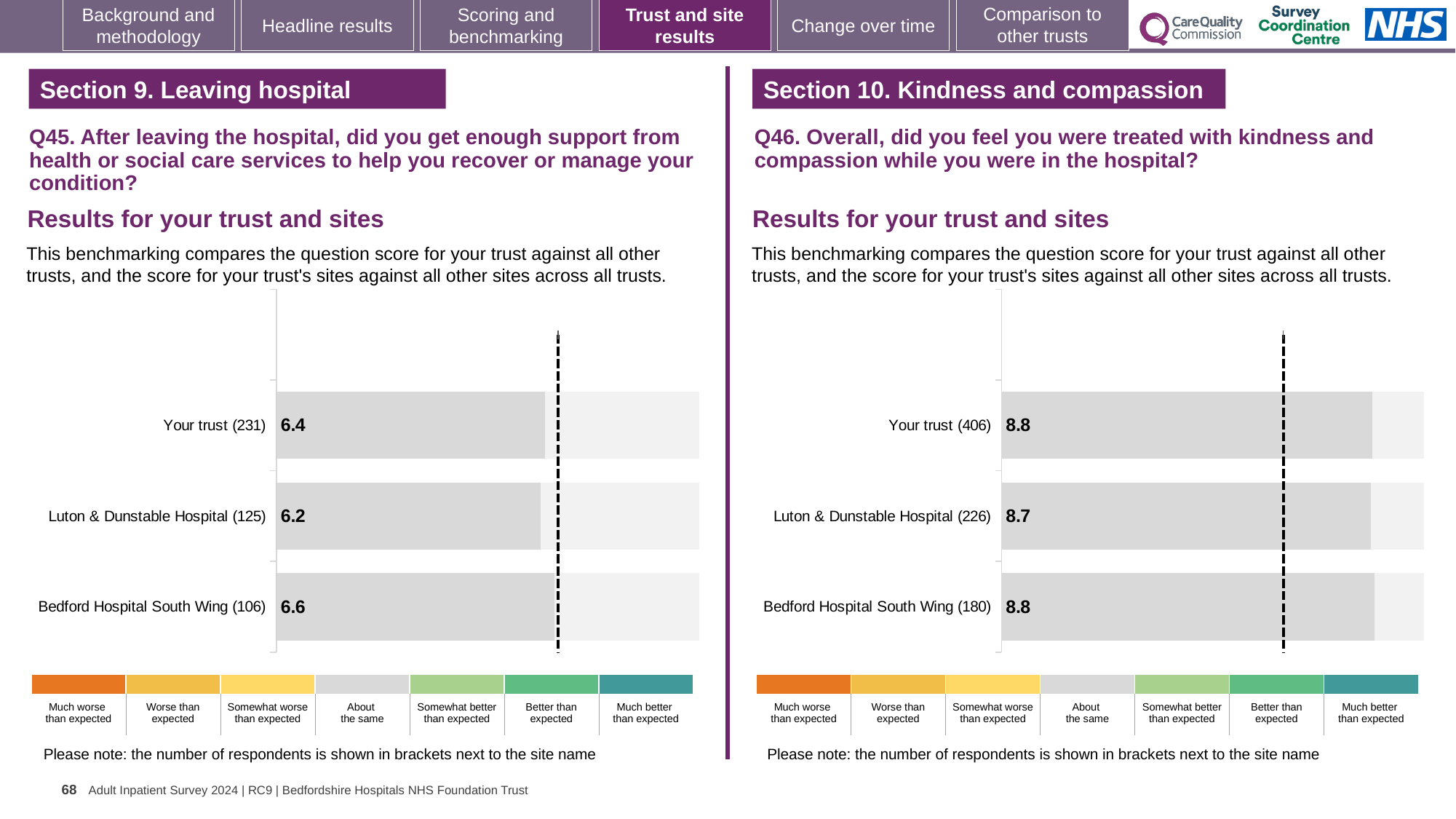
In the Q45 chart on the left, which site or trust has the highest score? Bedford Hospital South Wing (106) In the Q46 chart on the right, what is the difference between the scores for Your trust (406) and Luton & Dunstable Hospital (226)? 0.1 Which is larger: the Your trust score in the Q45 chart on the left or the Your trust score in the Q46 chart on the right? Q46 (8.8) In the Q45 chart on the left, which site or trust has the lowest score? Luton & Dunstable Hospital (125) What kind of chart is used in the Q46 chart on the right? Bar chart In the Q46 chart on the right, which site has the lowest score? Luton & Dunstable Hospital (226) In the Q45 chart on the left, what is the score for Your trust (231)? 6.4 In the Q45 chart on the left, what is the score for Luton & Dunstable Hospital (125)? 6.2 In the Q45 chart on the left, what is the difference between the scores for Bedford Hospital South Wing (106) and Luton & Dunstable Hospital (125)? 0.4 In the Q46 chart on the right, what is the score for Luton & Dunstable Hospital (226)? 8.7 In the Q46 chart on the right, what is the score for Bedford Hospital South Wing (180)? 8.8 In the Q45 chart on the left, how many bars are plotted? 3